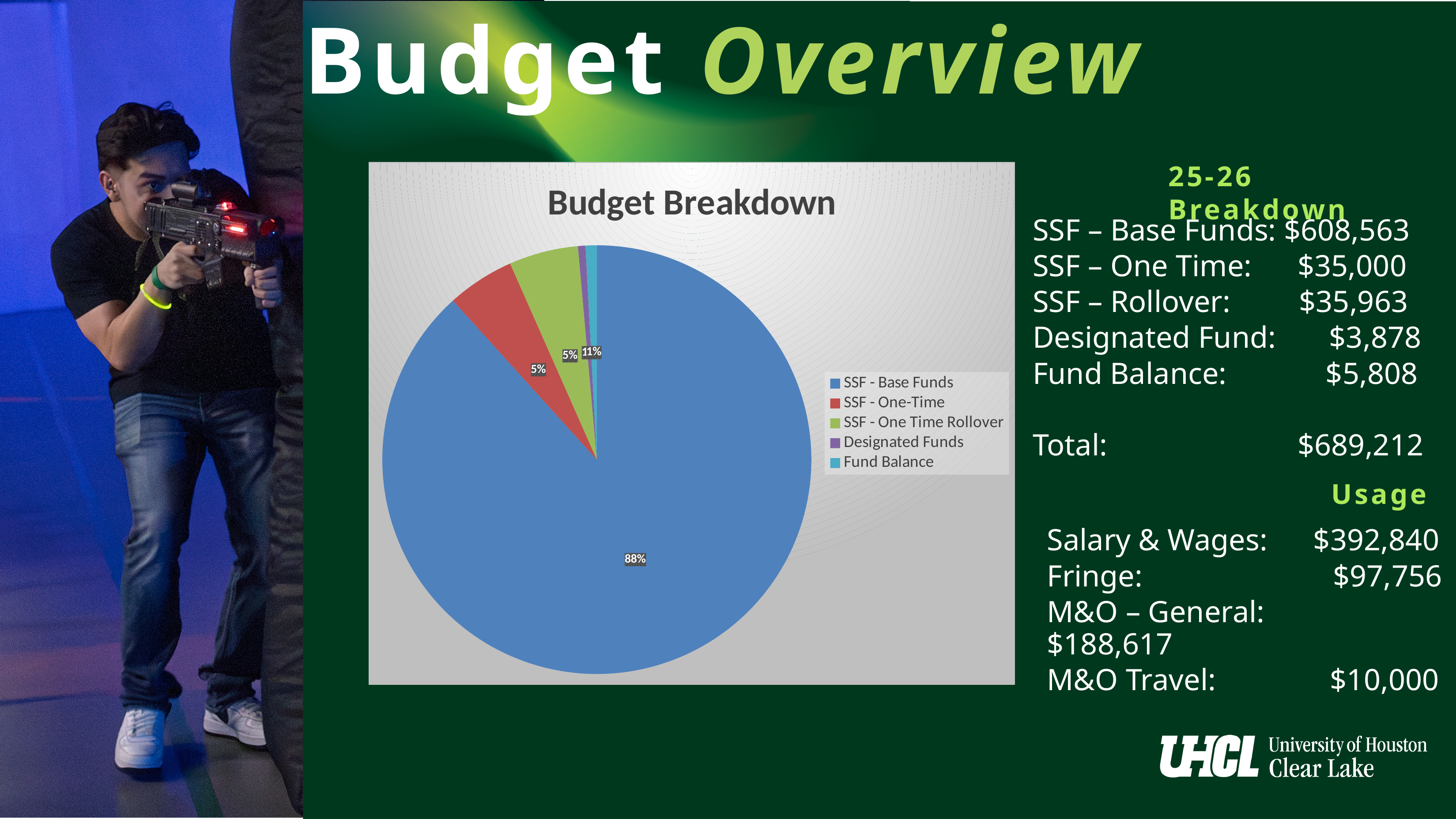
What share of the pie does SSF - Base Funds represent? 88% Which is larger, the slice for SSF - Base Funds or the slice for SSF - One-Time? SSF - Base Funds What is the difference in percentage points between the SSF - Base Funds share and the SSF - One-Time share? 83% What share of the pie does SSF - One Time Rollover represent? 5% Which category has the largest slice of the pie? SSF - Base Funds What colour is the SSF - Base Funds slice? blue What share of the pie does SSF - One-Time represent? 5% How many categories does the pie chart's legend list? 5 Which is larger, the slice for SSF - One Time Rollover or the slice for Fund Balance? SSF - One Time Rollover What kind of chart is shown on the slide? pie chart What is the title of the chart? Budget Breakdown